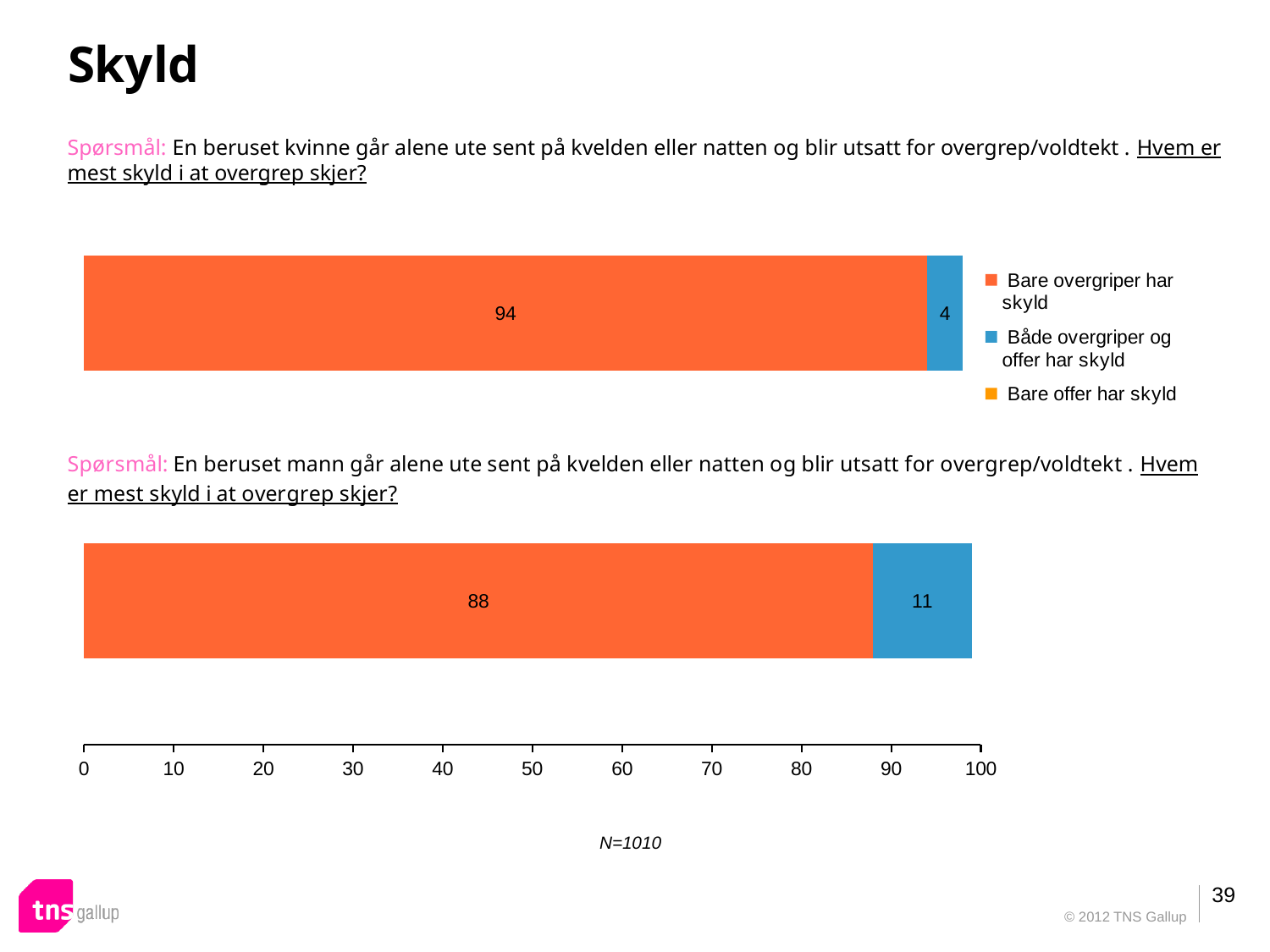
How many series does the legend list? 3 In the top chart (about a drunk woman), what is the value for 'Bare overgriper har skyld'? 94 In the top chart (about a drunk woman), which segment is the largest? Bare overgriper har skyld In the top chart (about a drunk woman), what is the value for 'Både overgriper og offer har skyld'? 4 In the bottom chart (about a drunk man), what is the value for 'Både overgriper og offer har skyld'? 11 In the bottom chart (about a drunk man), what is the difference between the 'Bare overgriper har skyld' value and the 'Både overgriper og offer har skyld' value? 77 What kind of chart is shown on the slide? stacked bar chart In the bottom chart (about a drunk man), what is the value for 'Bare overgriper har skyld'? 88 What is the total of the labelled segments in the bottom chart (about a drunk man)? 99 What is the difference between the 'Bare overgriper har skyld' value in the top chart and the same value in the bottom chart? 6 Which chart has the larger value for 'Både overgriper og offer har skyld', the top chart or the bottom chart? the bottom chart What colour is the 'Bare overgriper har skyld' segment in the legend? orange